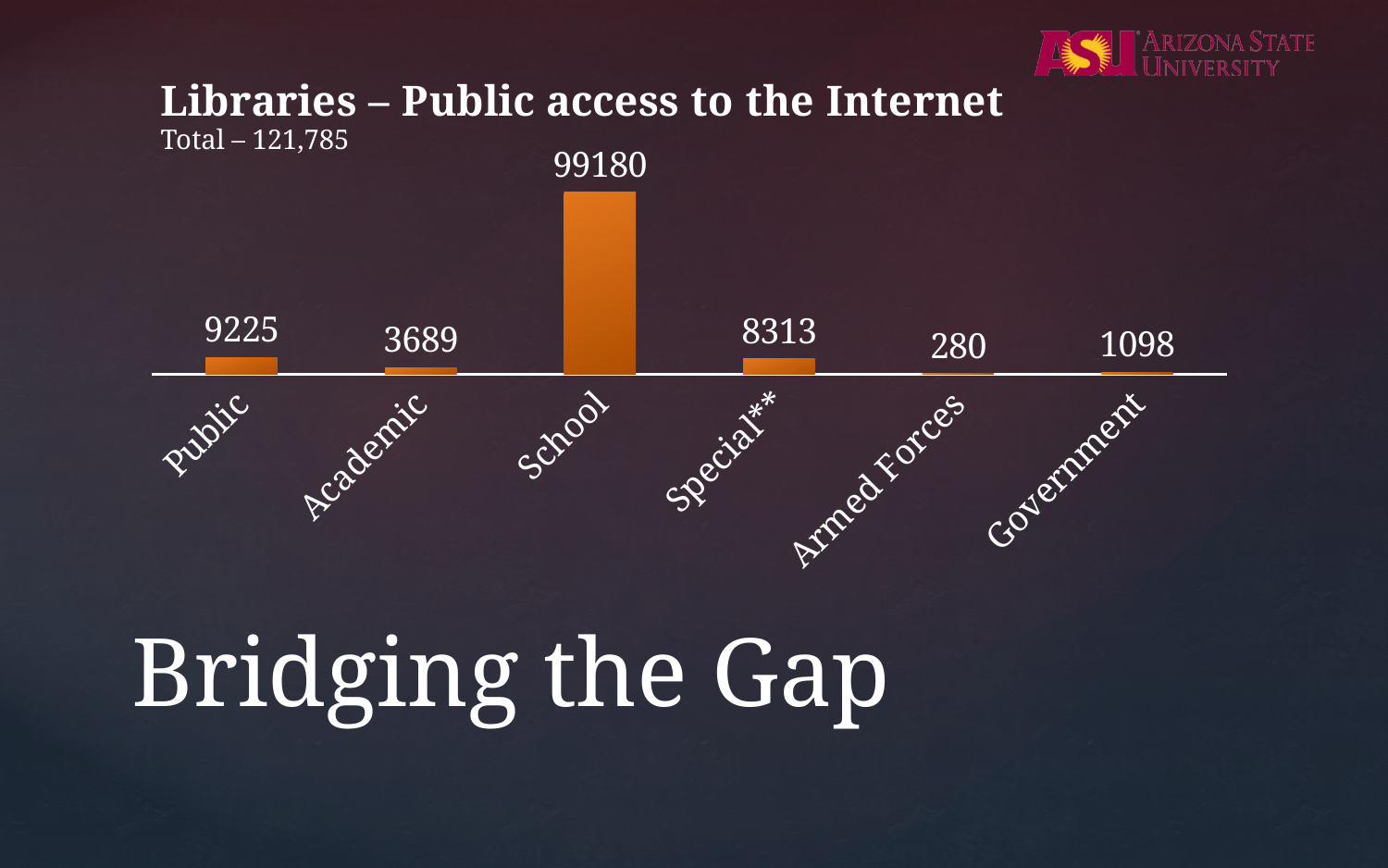
Which category has the highest value? School Which category has the lowest value? Armed Forces What kind of chart is shown on the slide? Bar chart Which is larger, the value for Academic or the value for Special**? Special** What is the title of the chart? Libraries – Public access to the Internet What is the value for Public? 9225 What is the value for School? 99180 What is the difference between the values for Academic and Government? 2591 What is the difference between the values for Public and Special**? 912 How many categories are shown in the chart? 6 What is the value for Government? 1098 What is the value for Armed Forces? 280